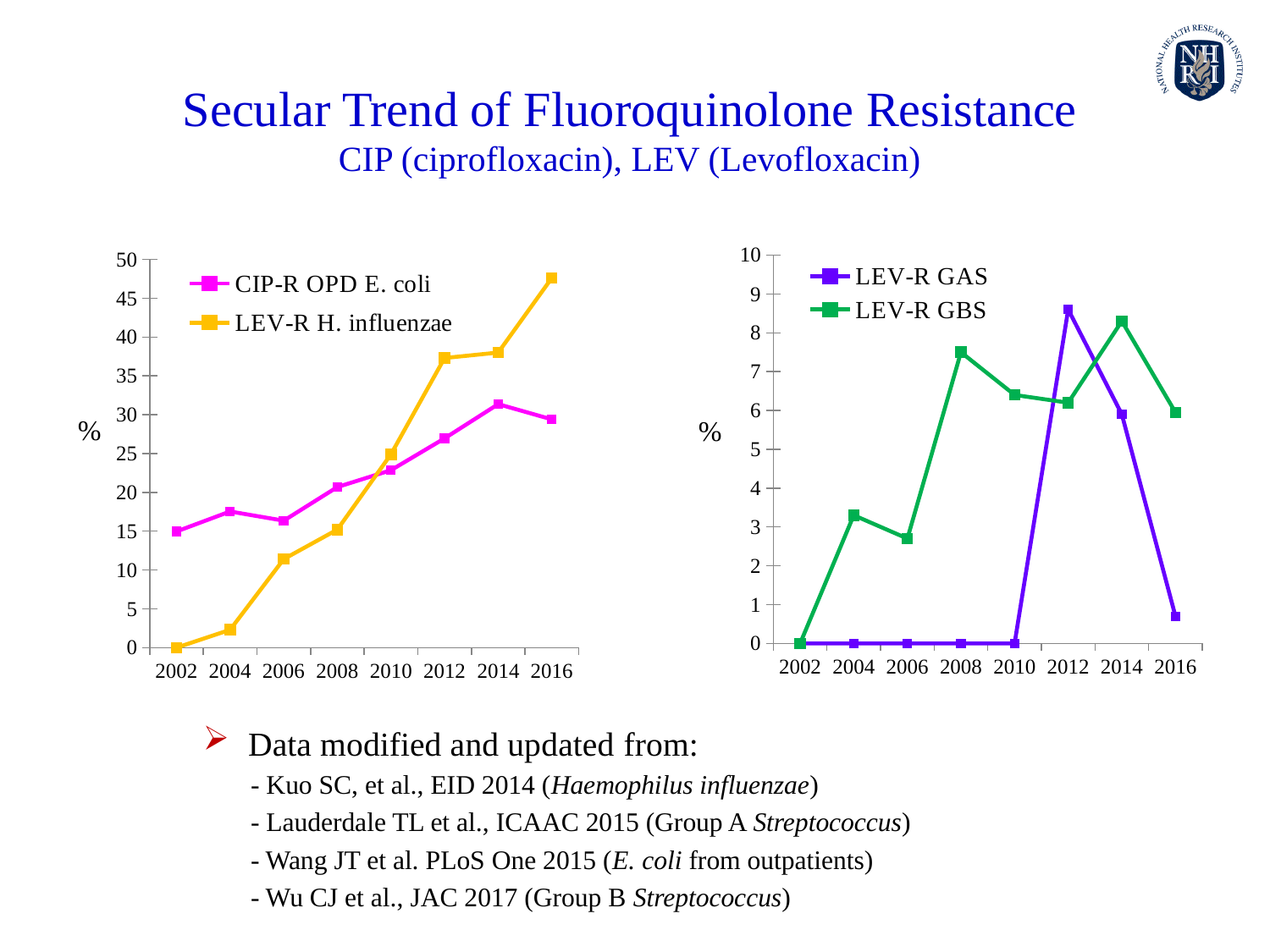
In the right chart, is the value for LEV-R GAS in 2012 greater or less than 8? greater In the right chart, which series has the larger value in 2014, LEV-R GAS or LEV-R GBS? LEV-R GBS In the left chart, which series has the larger value in 2012, CIP-R OPD E. coli or LEV-R H. influenzae? LEV-R H. influenzae In the left chart, is the value for LEV-R H. influenzae in 2016 greater or less than 45? greater How many series does the legend of the right chart list? 2 In the right chart, is the value for LEV-R GAS in 2016 greater or less than 1? less In the right chart, does the LEV-R GAS line rise or fall from 2012 to 2016? fall In the left chart, in which year does LEV-R H. influenzae reach its highest value? 2016 How many years are plotted along the x axis of the left chart? 8 In the right chart, in which year does LEV-R GAS reach its highest value? 2012 What kind of chart is the left chart on the slide? line chart